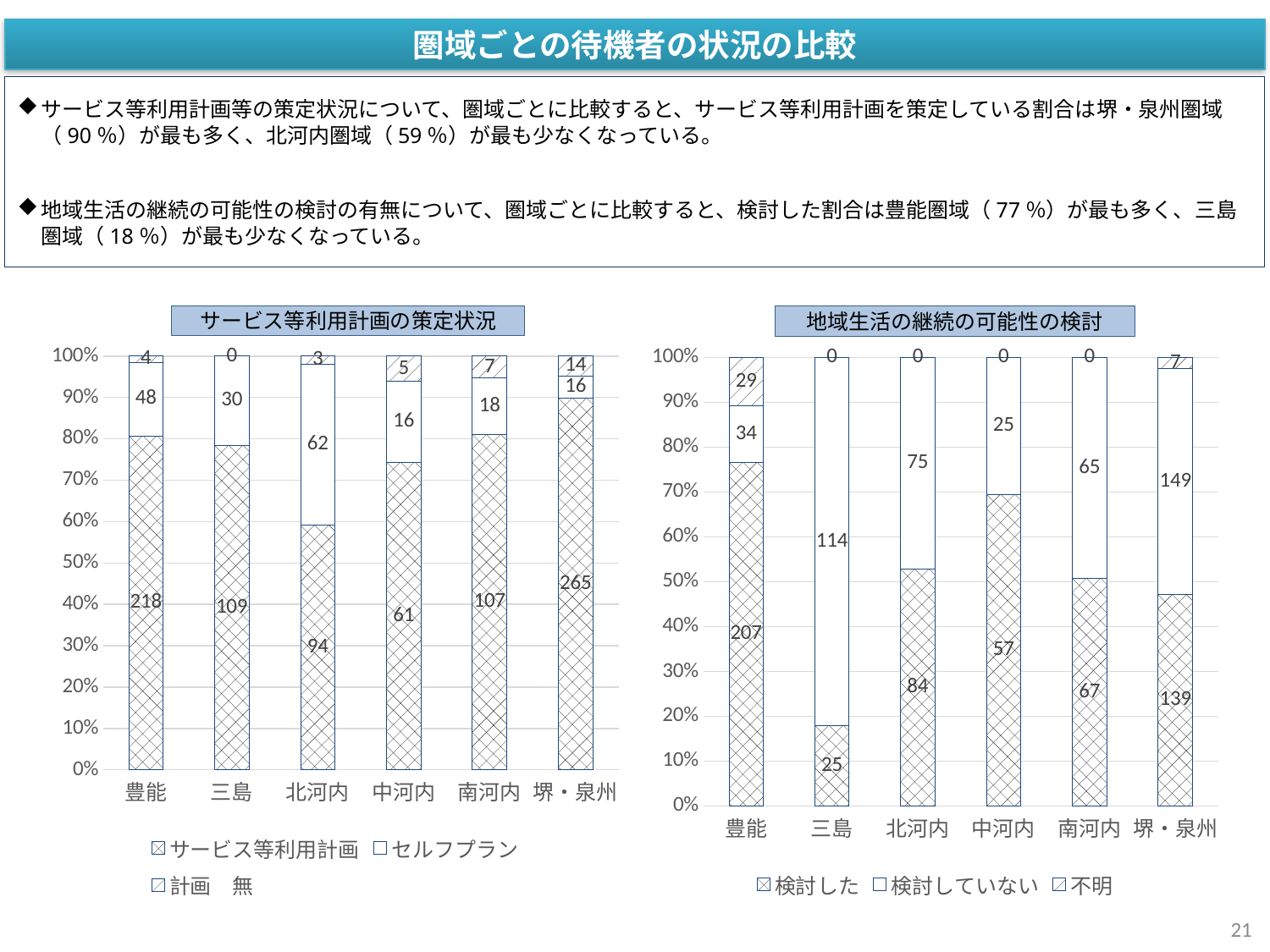
In the 地域生活の継続の可能性の検討 chart, what is the value of 不明 for 豊能? 29 In the 地域生活の継続の可能性の検討 chart, which category has the lowest 検討した value? 三島 In the 地域生活の継続の可能性の検討 chart, how many categories are shown on the x axis? 6 In the サービス等利用計画の策定状況 chart, what is the value of セルフプラン for 北河内? 62 What kind of chart is the 地域生活の継続の可能性の検討 chart? Stacked bar chart In the サービス等利用計画の策定状況 chart, how many series does the legend list? 3 In the 地域生活の継続の可能性の検討 chart, what is the total of the stacked bar for 三島? 139 In the 地域生活の継続の可能性の検討 chart, what is the value of 検討していない for 三島? 114 In the サービス等利用計画の策定状況 chart, what is the value of サービス等利用計画 for 豊能? 218 In the サービス等利用計画の策定状況 chart, which category has the highest サービス等利用計画 value? 堺・泉州 In the サービス等利用計画の策定状況 chart, what is the total of the stacked bar for 豊能? 270 In the 地域生活の継続の可能性の検討 chart, what is the difference between 検討していない and 検討した for 堺・泉州? 10